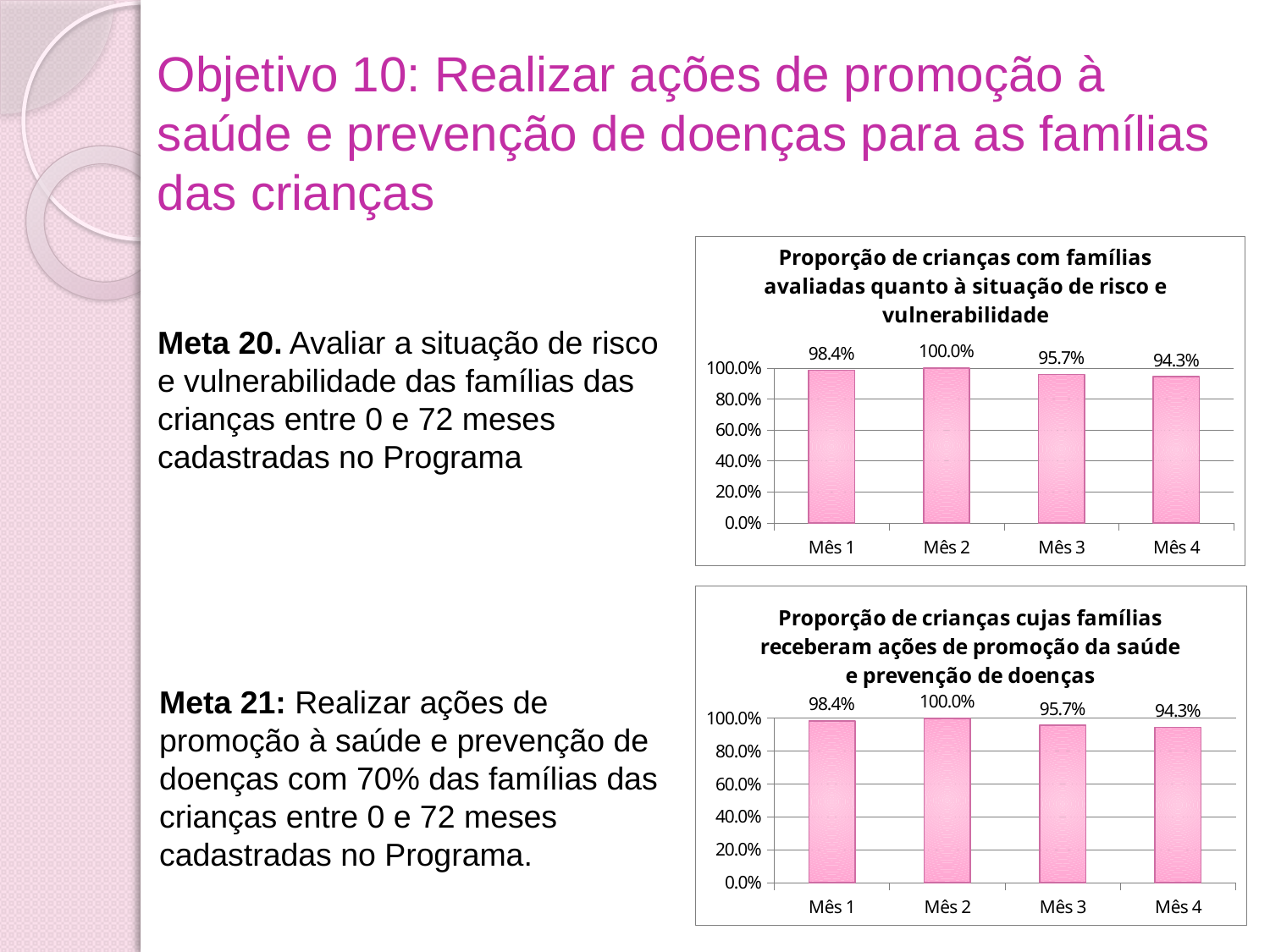
In the bottom chart (Proporção de crianças cujas famílias receberam ações de promoção da saúde e prevenção de doenças), what is the value for Mês 2? 100.0% In the top chart (Proporção de crianças com famílias avaliadas quanto à situação de risco e vulnerabilidade), what is the value for Mês 1? 98.4% In the top chart (Proporção de crianças com famílias avaliadas quanto à situação de risco e vulnerabilidade), what is the difference between the values for Mês 2 and Mês 4? 5.7% What kind of chart is the top chart (Proporção de crianças com famílias avaliadas quanto à situação de risco e vulnerabilidade)? Bar chart In the top chart (Proporção de crianças com famílias avaliadas quanto à situação de risco e vulnerabilidade), which month has the highest value? Mês 2 In the top chart (Proporção de crianças com famílias avaliadas quanto à situação de risco e vulnerabilidade), which month has the lowest value? Mês 4 In the bottom chart (Proporção de crianças cujas famílias receberam ações de promoção da saúde e prevenção de doenças), do the values rise or fall from Mês 2 to Mês 4? Fall What colour are the bars in the top chart (Proporção de crianças com famílias avaliadas quanto à situação de risco e vulnerabilidade)? Pink In the top chart (Proporção de crianças com famílias avaliadas quanto à situação de risco e vulnerabilidade), how many months are shown on the x axis? 4 In the bottom chart (Proporção de crianças cujas famílias receberam ações de promoção da saúde e prevenção de doenças), what is the difference between the values for Mês 1 and Mês 4? 4.1% In the bottom chart (Proporção de crianças cujas famílias receberam ações de promoção da saúde e prevenção de doenças), what is the value for Mês 3? 95.7% In the bottom chart (Proporção de crianças cujas famílias receberam ações de promoção da saúde e prevenção de doenças), which is larger, the value for Mês 1 or the value for Mês 3? Mês 1